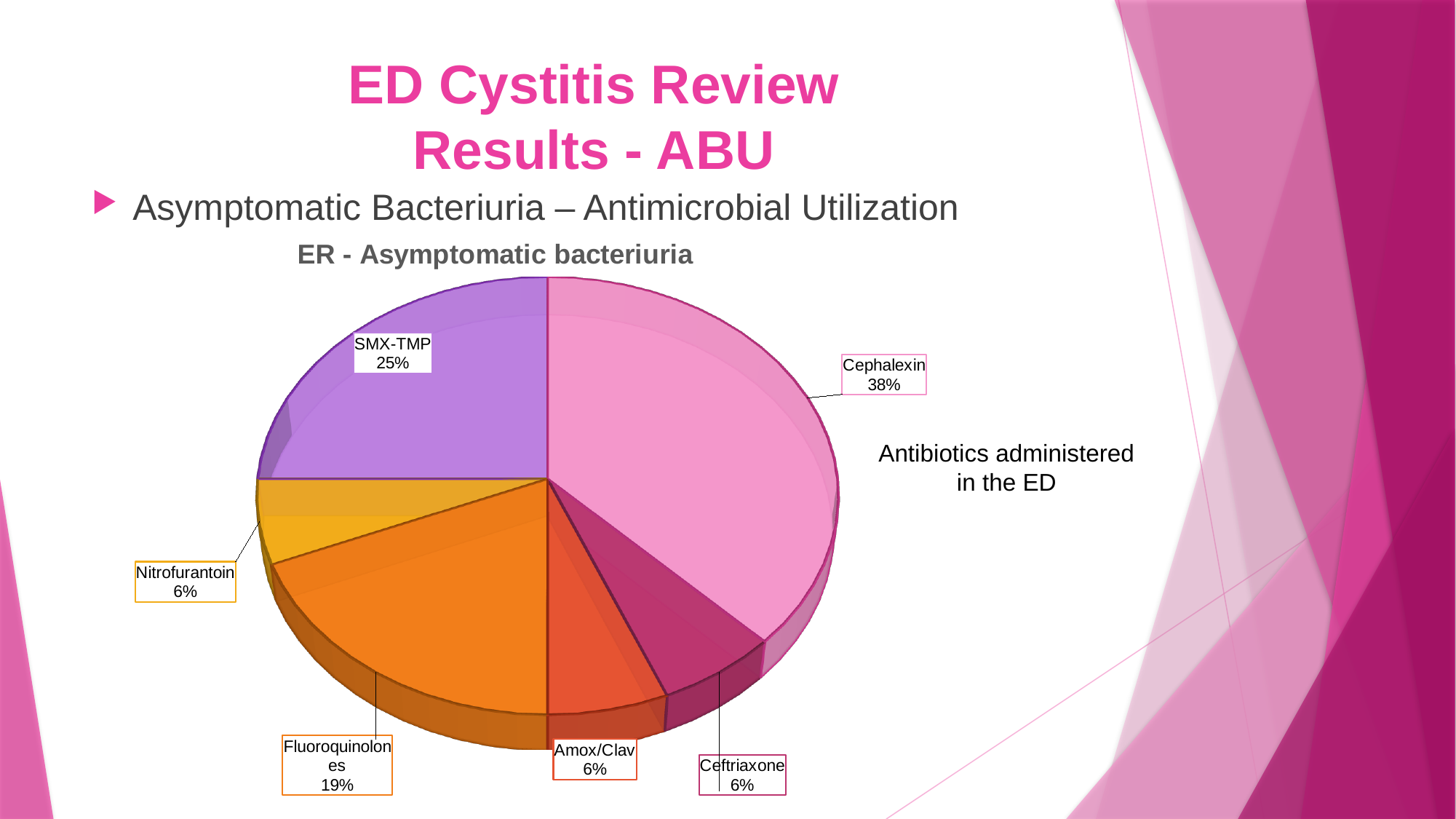
What is the difference in percentage points between Cephalexin and SMX-TMP? 13% What share of the pie does Cephalexin represent? 38% What share of the pie does Fluoroquinolones represent? 19% Which antibiotic has the largest slice of the pie? Cephalexin What share of the pie does SMX-TMP represent? 25% What is the difference in percentage points between SMX-TMP and Fluoroquinolones? 6% What is the value shown for Nitrofurantoin? 6% What is the value shown for Ceftriaxone? 6% Which is larger, the share for Fluoroquinolones or the share for Amox/Clav? Fluoroquinolones How many antibiotic categories are shown in the pie chart? 6 What kind of chart is shown on the slide? Pie chart What is the title of the chart? ER - Asymptomatic bacteriuria